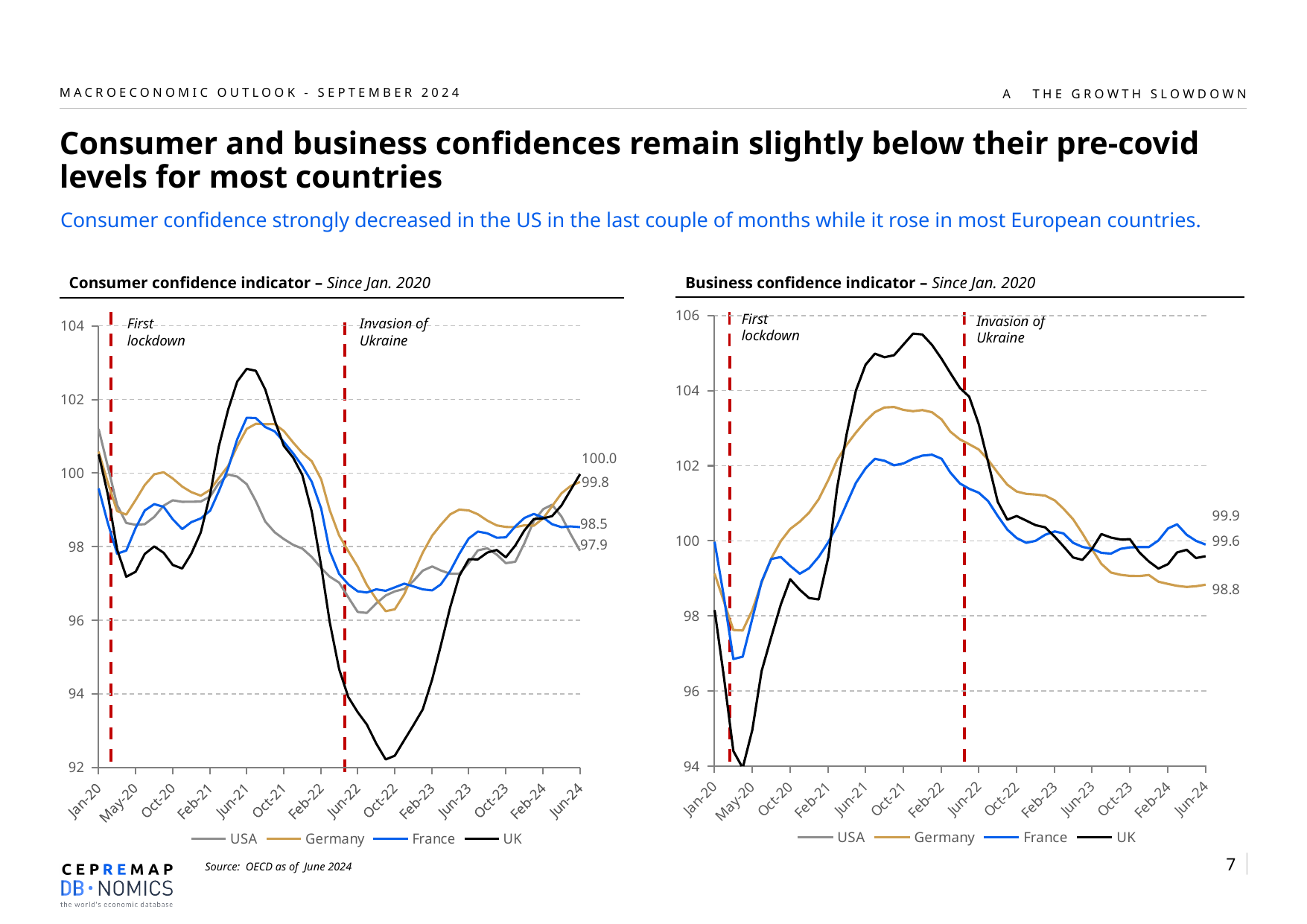
In the Consumer confidence indicator chart, is the value for the UK at Oct-22 greater or less than 94? less In the Consumer confidence indicator chart, what is the value for the UK at Jun-24? 100.0 In the Consumer confidence indicator chart, what is the value for the USA at Jun-24? 97.9 In the Consumer confidence indicator chart, what is the difference between the UK and USA values at Jun-24? 2.1 In the Business confidence indicator chart, which is larger at Jun-24: France or Germany? France In the Business confidence indicator chart, what is the difference between the France and Germany values at Jun-24? 1.1 In the Consumer confidence indicator chart, which country has the highest value at Jun-24? UK What two events do the red dashed vertical lines mark in the Consumer confidence indicator chart? First lockdown and Invasion of Ukraine What kind of chart is the Consumer confidence indicator chart? Line chart In the Business confidence indicator chart, is the value for the UK at Oct-21 greater or less than 104? greater How many series does the legend of the Business confidence indicator chart list? 4 In the Business confidence indicator chart, what is the value for Germany at Jun-24? 98.8